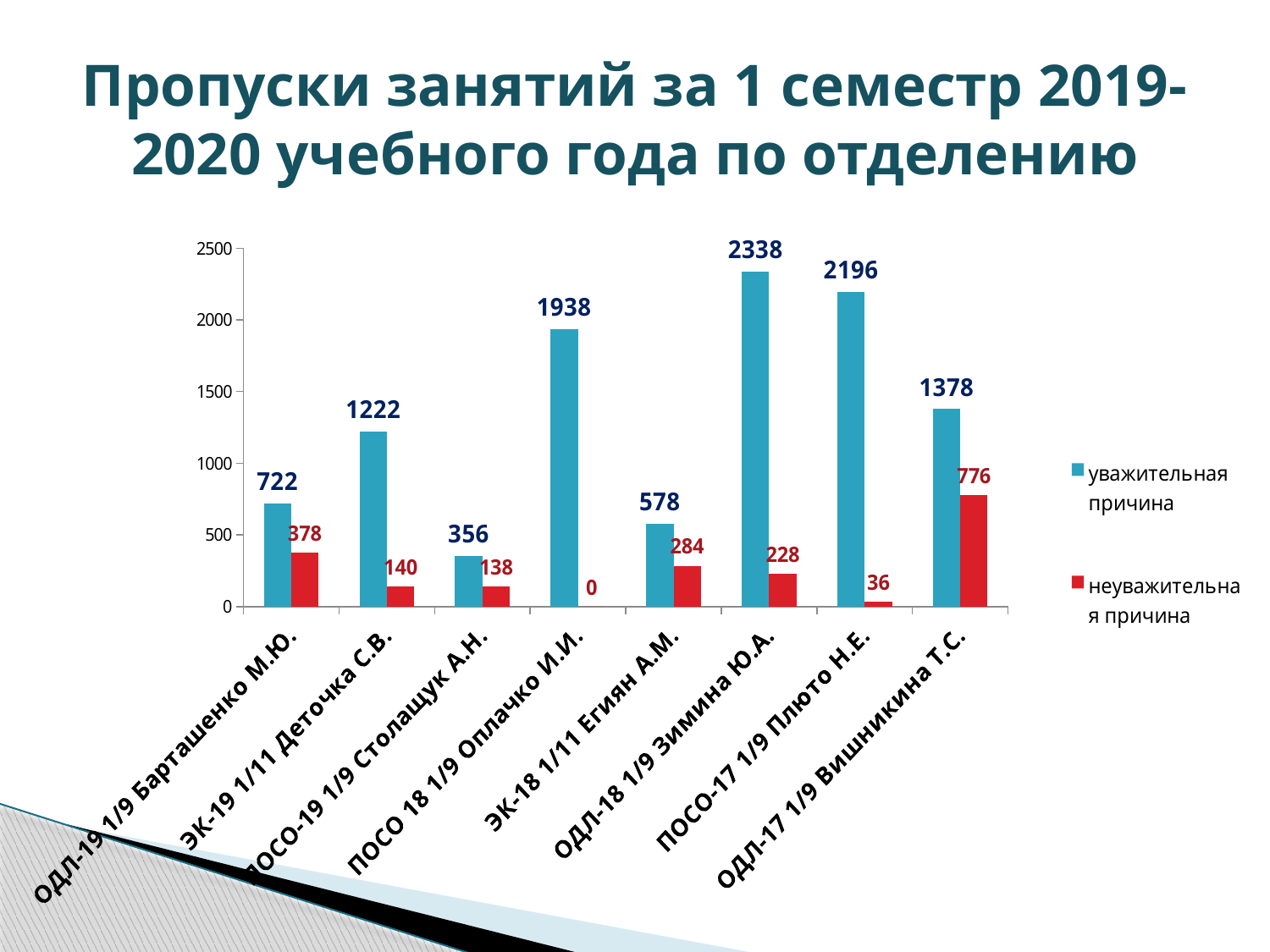
What kind of chart is shown on the slide? Bar chart Which group has the highest value for 'неуважительная причина'? ОДЛ-17 1/9 Вишникина Т.С. Which is larger: 'уважительная причина' for ЭК-19 1/11 Деточка С.В. or for ОДЛ-17 1/9 Вишникина Т.С.? ОДЛ-17 1/9 Вишникина Т.С. How many series does the legend list? 2 Which group has the highest value for 'уважительная причина'? ОДЛ-18 1/9 Зимина Ю.А. What is the value of 'неуважительная причина' for ПОСО 18 1/9 Оплачко И.И.? 0 What colour are the bars for 'неуважительная причина'? Red What is the value of 'уважительная причина' for ОДЛ-18 1/9 Зимина Ю.А.? 2338 What is the difference between 'уважительная причина' and 'неуважительная причина' for ОДЛ-19 1/9 Барташенко М.Ю.? 344 What is the value of 'неуважительная причина' for ОДЛ-17 1/9 Вишникина Т.С.? 776 How many groups are shown on the x axis? 8 Which group has the lowest value for 'уважительная причина'? ПОСО-19 1/9 Столащук А.Н.